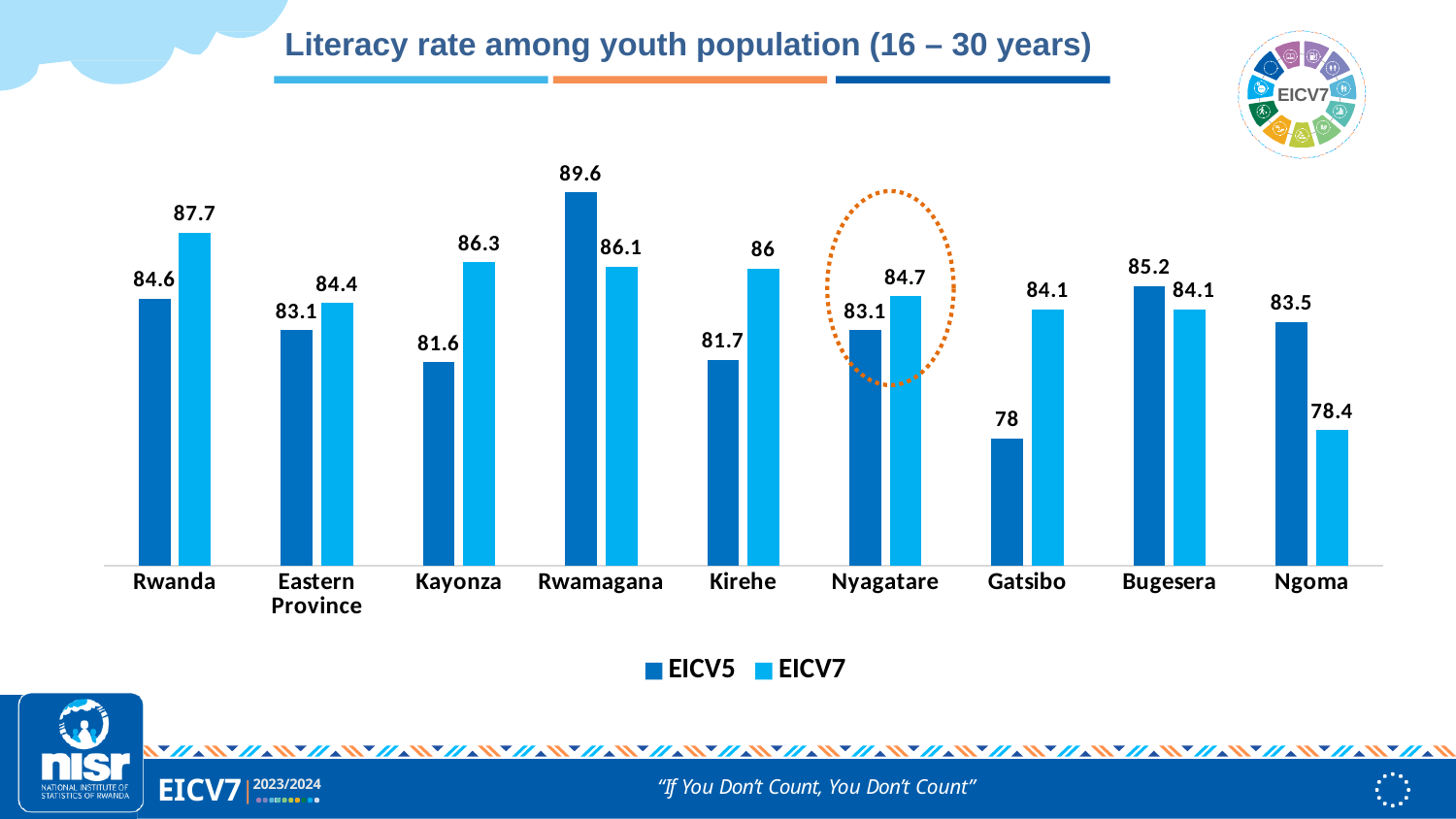
What kind of chart is shown on the slide? Bar chart What is the EICV5 literacy rate for Gatsibo? 78 Which category has the highest EICV5 value? Rwamagana Which category has the lowest EICV7 value? Ngoma Which category is highlighted with a dotted orange circle? Nyagatare How many categories are shown on the x axis? 9 What is the EICV7 value for Kayonza? 86.3 What is the EICV7 literacy rate for Rwanda? 87.7 What is the difference between the EICV7 and EICV5 values for Gatsibo? 6.1 For Bugesera, which is larger: the EICV5 value or the EICV7 value? EICV5 How many series does the legend list? 2 For Rwamagana, which is larger: the EICV5 value or the EICV7 value? EICV5